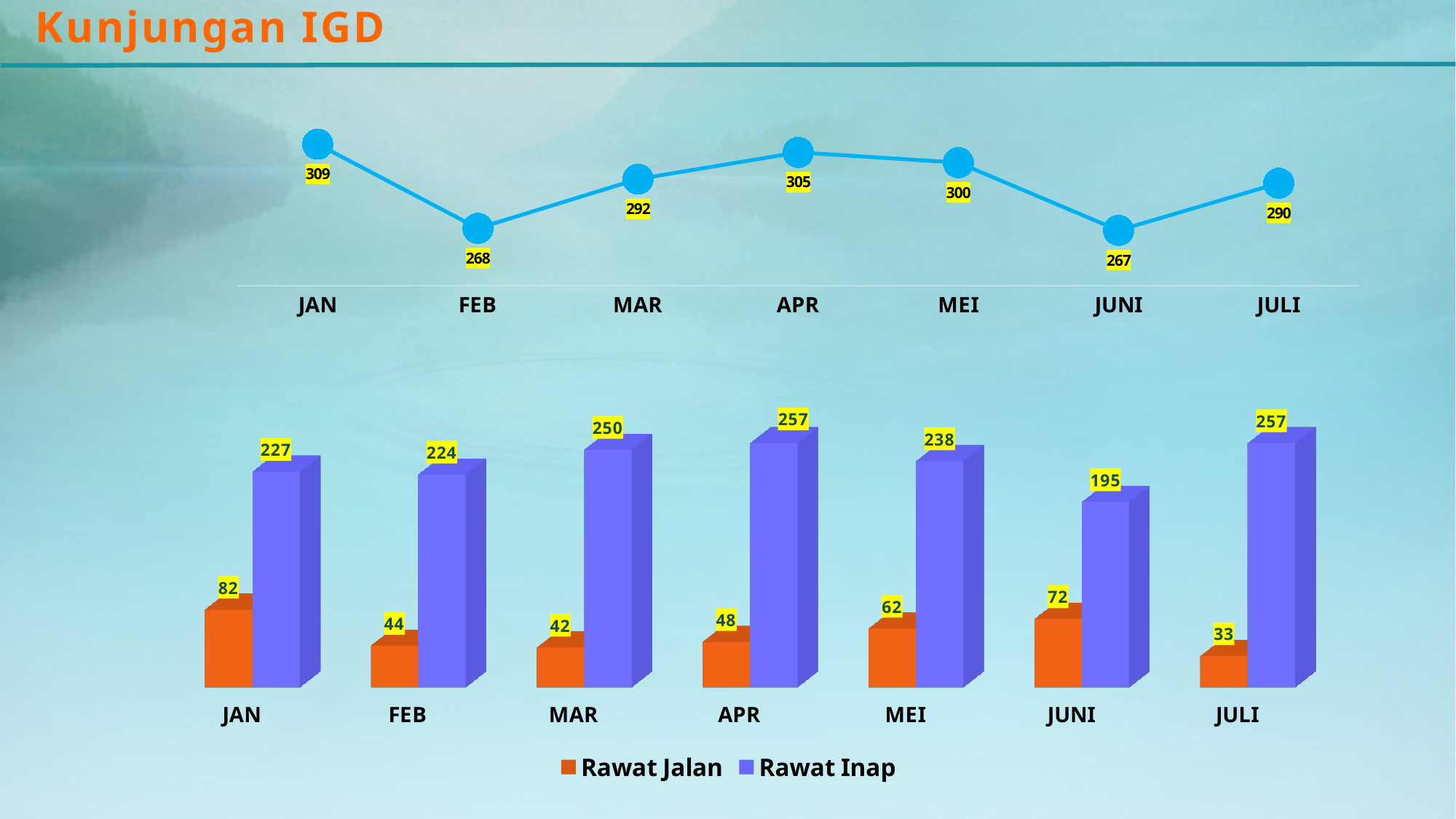
In the bottom bar chart, what is the Rawat Inap value for MAR? 250 In the top line chart, what is the value for JUNI? 267 In the top line chart, how many data points are plotted? 7 In the bottom bar chart, what is the Rawat Jalan value for MEI? 62 In the bottom bar chart, how many series does the legend list? 2 What type of chart is the bottom chart? bar chart In the bottom bar chart, which month has the lowest Rawat Inap value? JUNI In the top line chart, what is the value for APR? 305 In the bottom bar chart, which is larger: Rawat Inap for FEB or Rawat Inap for MEI? Rawat Inap for MEI In the top line chart, does the value rise or fall from MEI to JUNI? fall In the bottom bar chart, which month has the highest Rawat Jalan value? JAN In the top line chart, what is the difference between the JAN value and the FEB value? 41